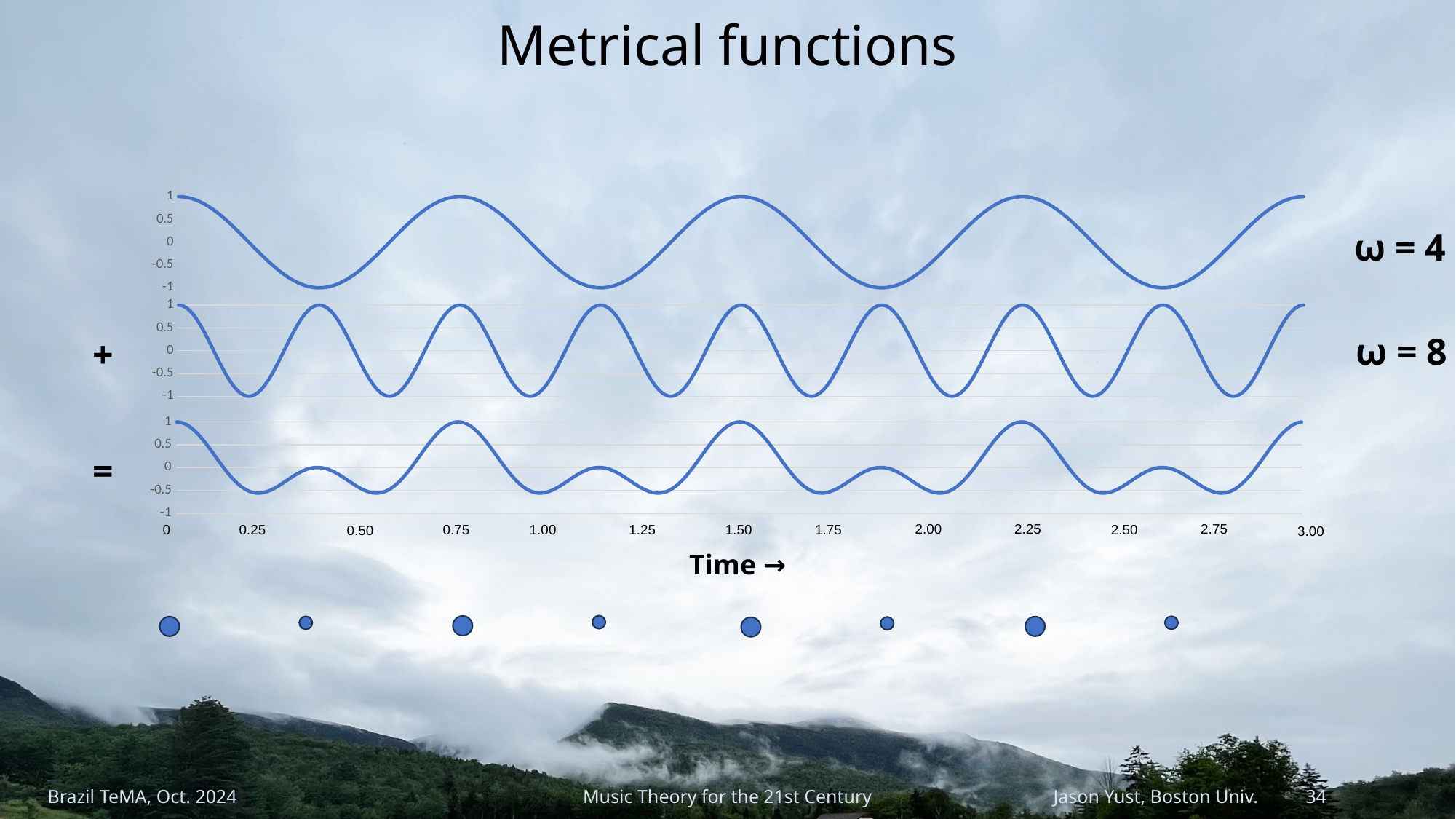
How many peaks (points reaching 1) does the top chart (ω = 4) have between time 0 and 3.00, including the endpoints? 5 How many separate line charts are stacked on the slide? 3 What kind of chart is used to show the metrical functions on this slide? line chart In the top chart (ω = 4), what is the value at time 0? 1 In the bottom (sum) chart, does the value rise or fall between time 0 and time 0.25? fall In the top chart (ω = 4), what is the value at time 0.75? 1 In the bottom (sum) chart, is the lowest value greater or less than -0.5? less How many peaks (points reaching 1) does the middle chart (ω = 8) have between time 0 and 3.00, including the endpoints? 9 At time 0.375 (halfway between 0.25 and 0.50), which chart has the larger value, the ω = 4 chart or the ω = 8 chart? ω = 8 What is the lowest value reached by the top chart (ω = 4)? -1 What is the label on the horizontal axis of the charts? Time → In the middle chart (ω = 8), what is the value at time 0.375, halfway between 0.25 and 0.50? 1